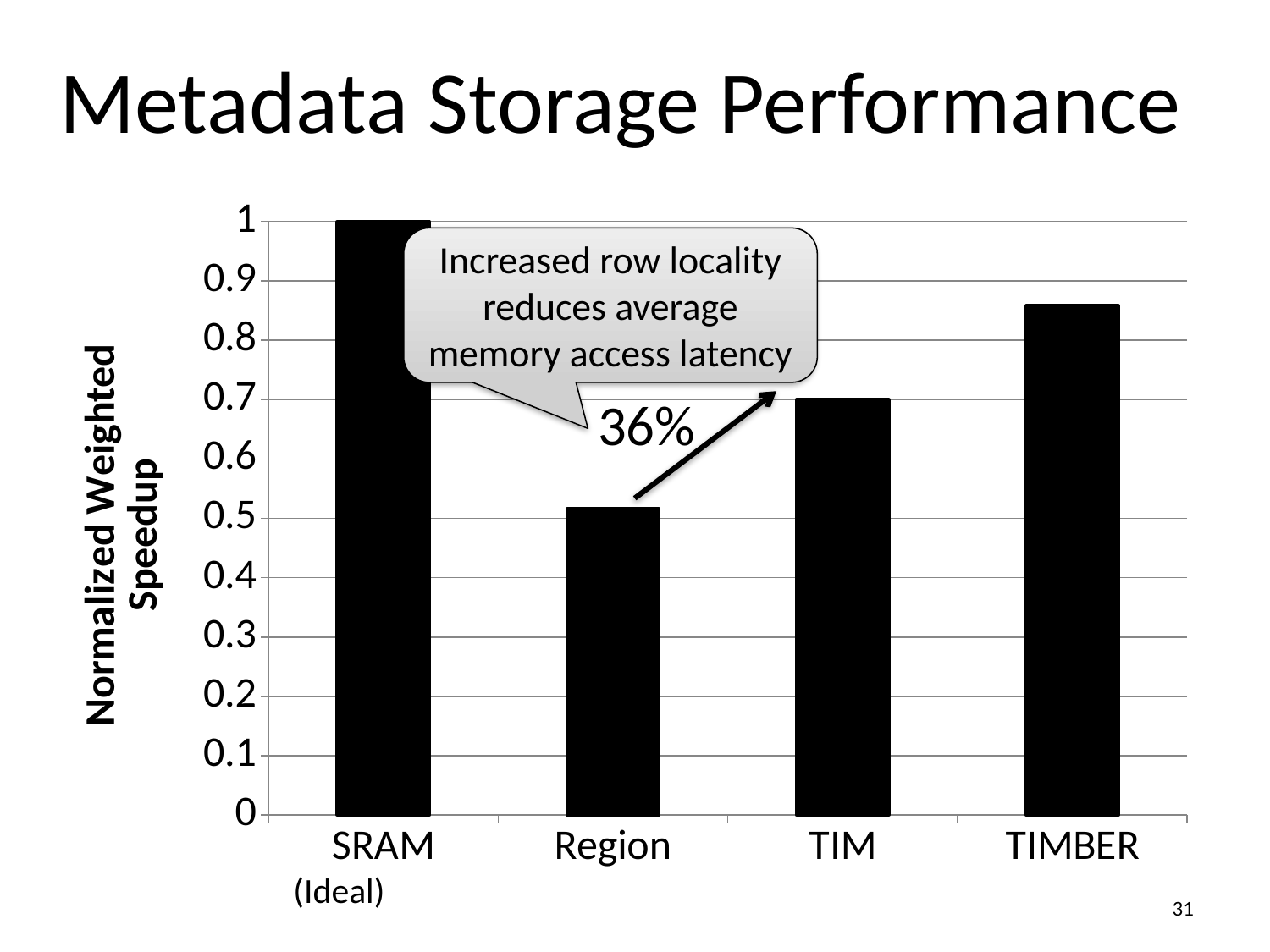
What percentage is written next to the arrow between the Region and TIM bars? 36% Which has a higher normalized weighted speedup, TIM or TIMBER? TIMBER Which category has the highest normalized weighted speedup? SRAM (Ideal) How many categories are plotted on the x axis of the chart? 4 Is the value for TIMBER greater or less than 0.8? greater What is the normalized weighted speedup for SRAM (Ideal)? 1 Is the value for TIMBER greater or less than 0.9? less What is the label of the y axis? Normalized Weighted Speedup What kind of chart is shown on the slide? bar chart Which category has the lowest normalized weighted speedup? Region Which has a higher normalized weighted speedup, Region or TIM? TIM Is the value for Region greater or less than 0.6? less